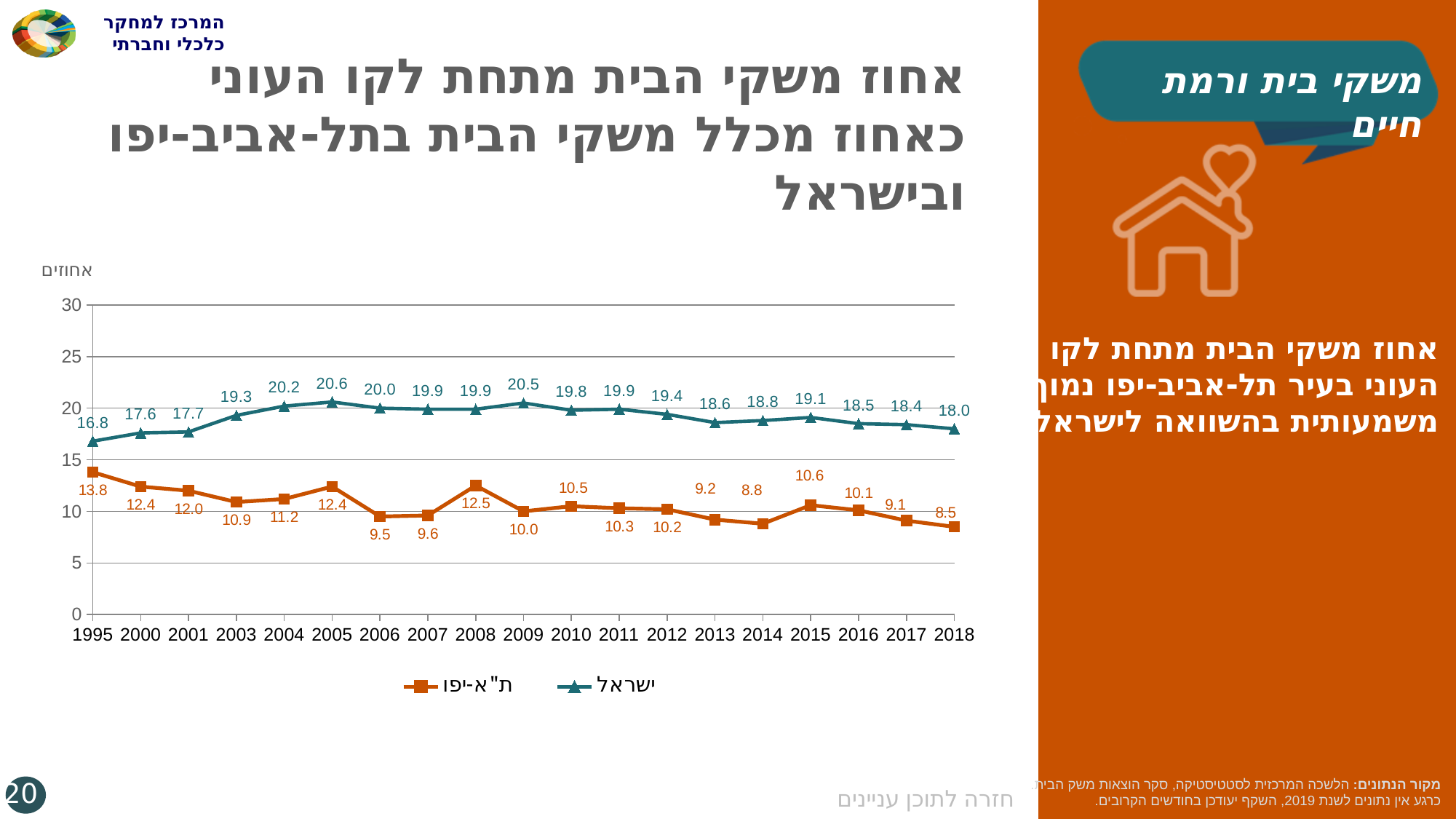
How many years are plotted on the x axis? 19 How many series does the legend list? 2 What is the value for ישראל in 2005? 20.6 What is the value for ת"א-יפו in 2018? 8.5 What is the difference between the ישראל and ת"א-יפו values in 2018? 9.5 Which series has the higher value in 2008, ישראל or ת"א-יפו? ישראל What kind of chart is shown on the slide? Line chart What is the value for ת"א-יפו in 1995? 13.8 What is the label on the y axis of the chart? אחוזים In which year does the ישראל series reach its highest value? 2005 In which year does the ת"א-יפו series reach its lowest value? 2018 Does the ת"א-יפו series generally rise or fall from 1995 to 2018? Fall